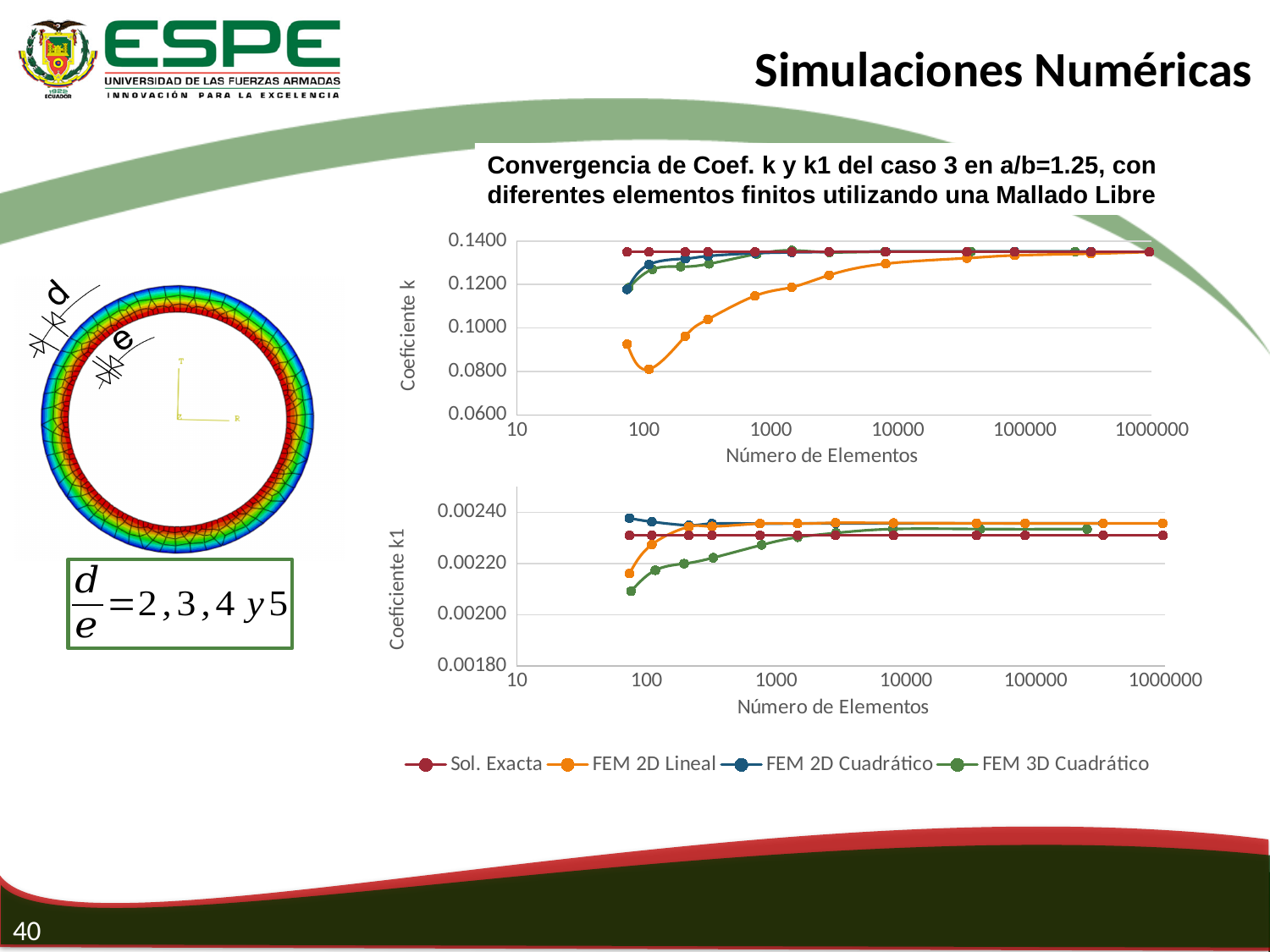
Which series is drawn in orange in the legend? FEM 2D Lineal In the top chart (Coeficiente k), is the first value of FEM 2D Lineal (near 70 elements) greater or less than 0.1000? less In the bottom chart (Coeficiente k1), does the FEM 3D Cuadrático series rise or fall as the number of elements increases? rise How many charts are shown on the slide? 2 In the top chart (Coeficiente k), is the value of Sol. Exacta greater or less than 0.1200? greater In the top chart (Coeficiente k), which series reaches the lowest value? FEM 2D Lineal How many series does the legend list? 4 What is the x-axis label of the bottom chart (Coeficiente k1)? Número de Elementos In the top chart (Coeficiente k), at about 100 elements, which is higher: Sol. Exacta or FEM 2D Lineal? Sol. Exacta What kind of chart is the top chart (Coeficiente k)? line chart In the bottom chart (Coeficiente k1), is the first value of FEM 2D Cuadrático greater or less than 0.00220? greater